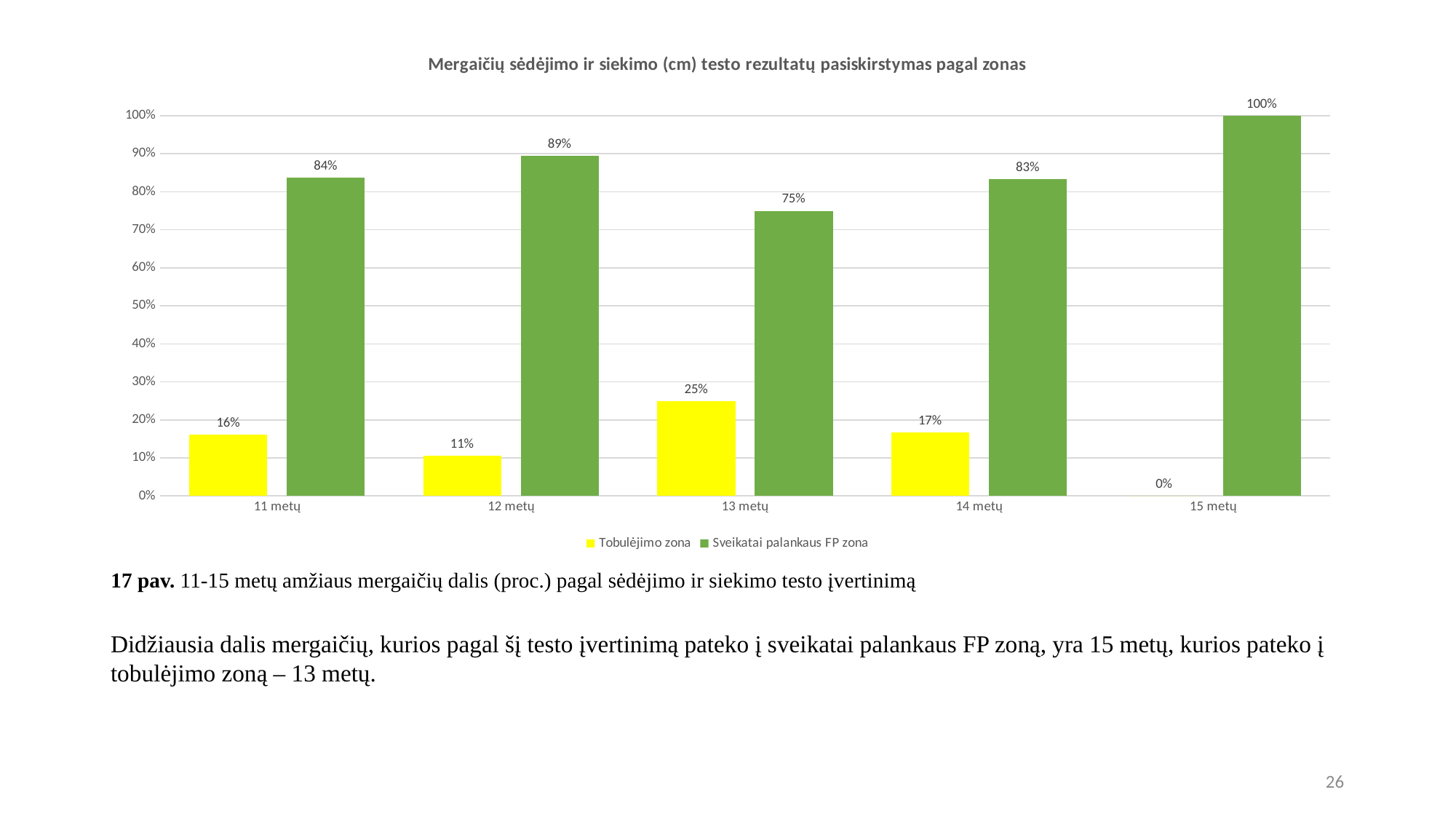
How many series does the legend list? 2 What colour are the Tobulėjimo zona bars? Yellow Which age group has the lowest value for Sveikatai palankaus FP zona? 13 metų Which age group has the highest value for Sveikatai palankaus FP zona? 15 metų Which age group has the highest value for Tobulėjimo zona? 13 metų Which is larger: the Tobulėjimo zona value for 11 metų or for 12 metų? 11 metų What is the value for Tobulėjimo zona at 15 metų? 0% What is the difference between the Sveikatai palankaus FP zona values for 11 metų and 14 metų? 1% How many age groups are shown on the x axis? 5 What is the value for Sveikatai palankaus FP zona at 12 metų? 89% What kind of chart is shown on the slide? Bar chart What is the value for Tobulėjimo zona at 13 metų? 25%